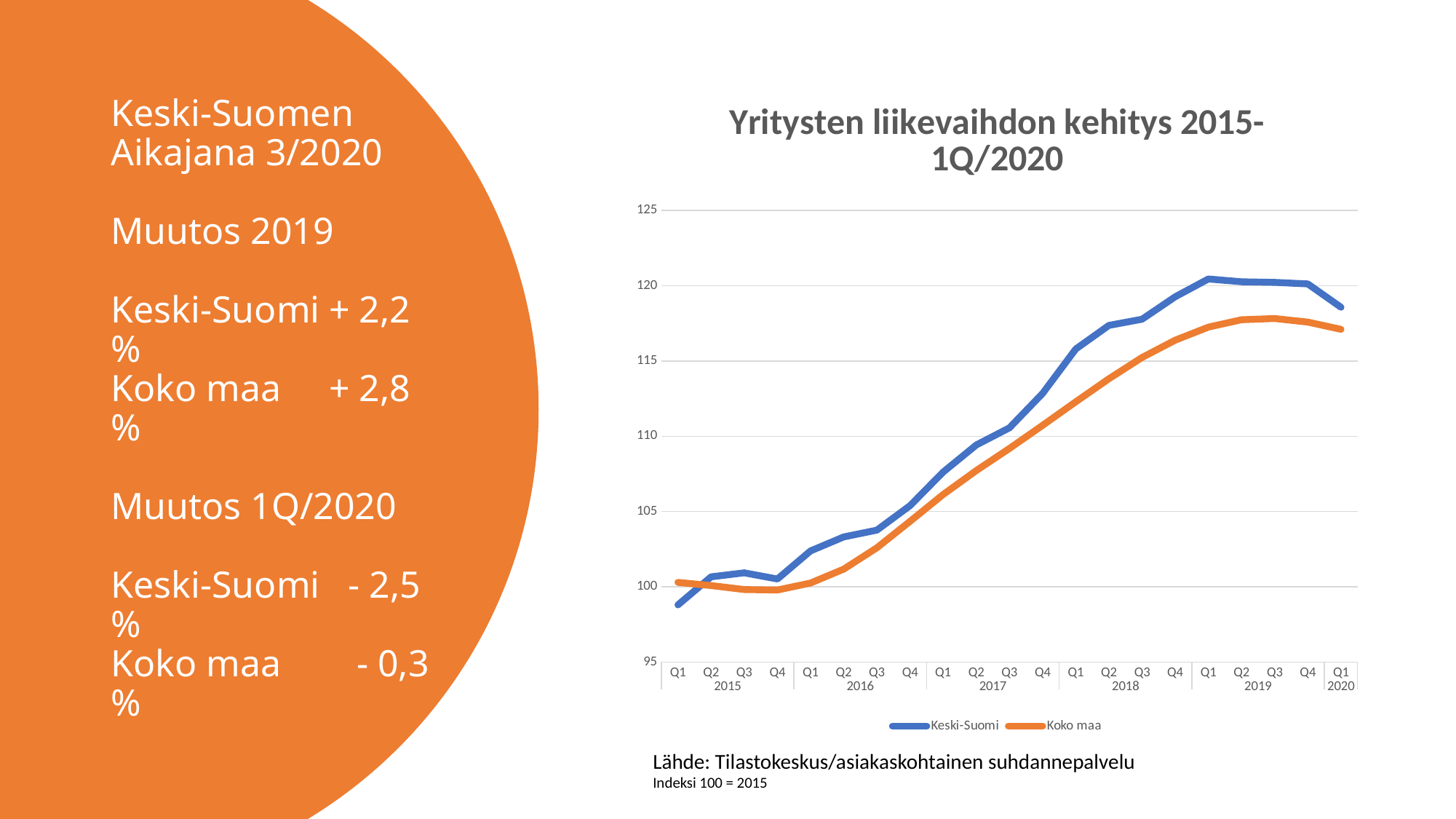
How many quarterly points are plotted along the x axis for each series? 21 How many series does the chart legend list? 2 Is the Koko maa value for Q1 2015 greater or less than 105? less What is the title of the chart? Yritysten liikevaihdon kehitys 2015-1Q/2020 Is the Keski-Suomi value for Q1 2017 greater or less than 105? greater In Q1 2020, which series has the higher value, Keski-Suomi or Koko maa? Keski-Suomi In Q1 2015, which series has the higher value, Keski-Suomi or Koko maa? Koko maa At which quarter is the Keski-Suomi series at its lowest? Q1 2015 Which two series are listed in the chart legend? Keski-Suomi and Koko maa Is the Koko maa value for Q1 2018 greater or less than 110? greater What kind of chart is shown on the slide? line chart